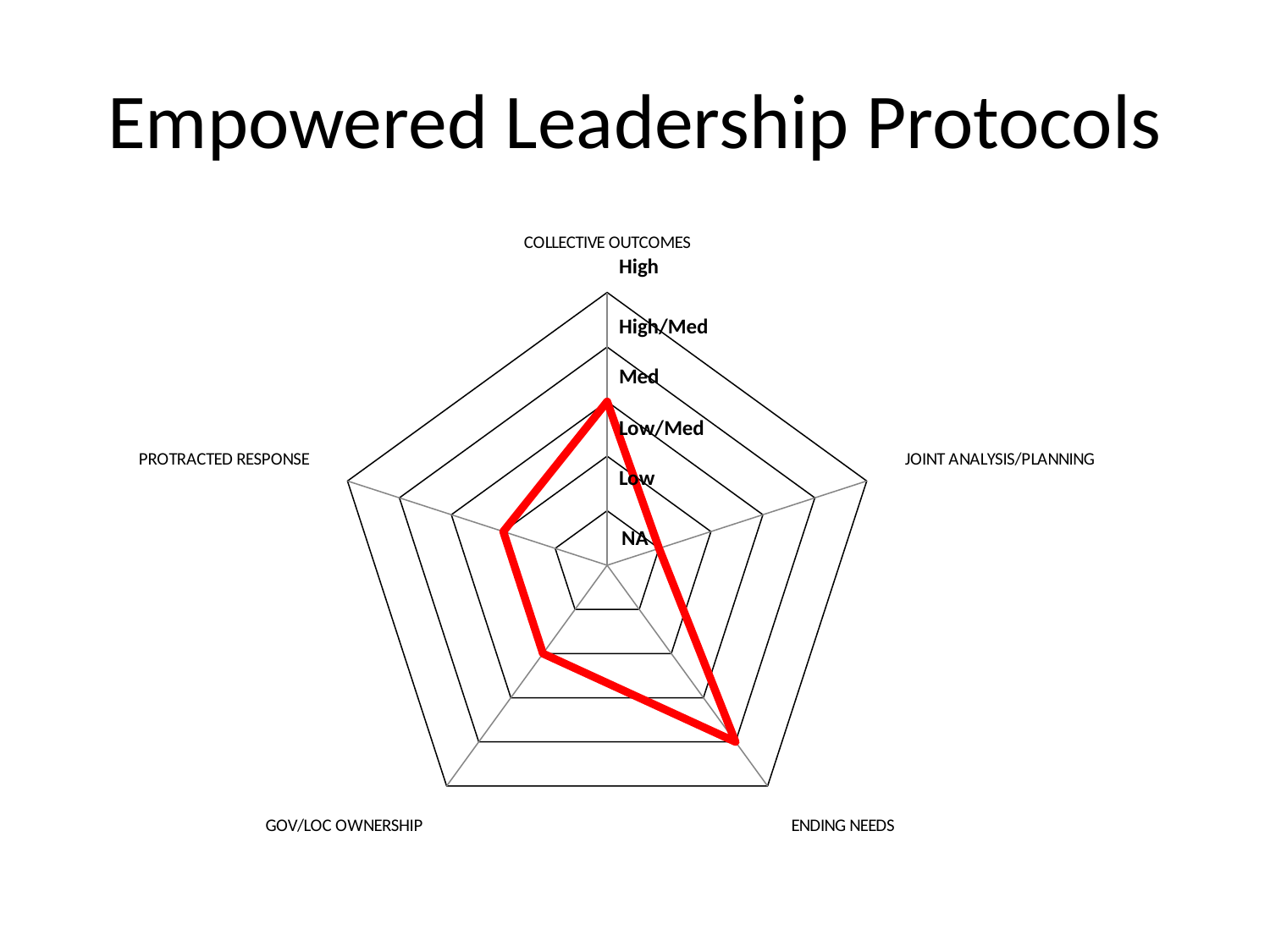
Is the rating for ENDING NEEDS above or below Med? above What type of chart is shown on the slide? Radar chart What is the rating for PROTRACTED RESPONSE? Low/Med Which is rated higher, ENDING NEEDS or PROTRACTED RESPONSE? ENDING NEEDS How many categories (axes) does the radar chart have? 5 What is the rating for ENDING NEEDS? High/Med What colour is the plotted data line? Red Which is rated higher, COLLECTIVE OUTCOMES or GOV/LOC OWNERSHIP? COLLECTIVE OUTCOMES What is the highest level on the chart's rating scale? High What is the rating for COLLECTIVE OUTCOMES? Med What is the rating for GOV/LOC OWNERSHIP? Low/Med Which category has the highest rating? ENDING NEEDS